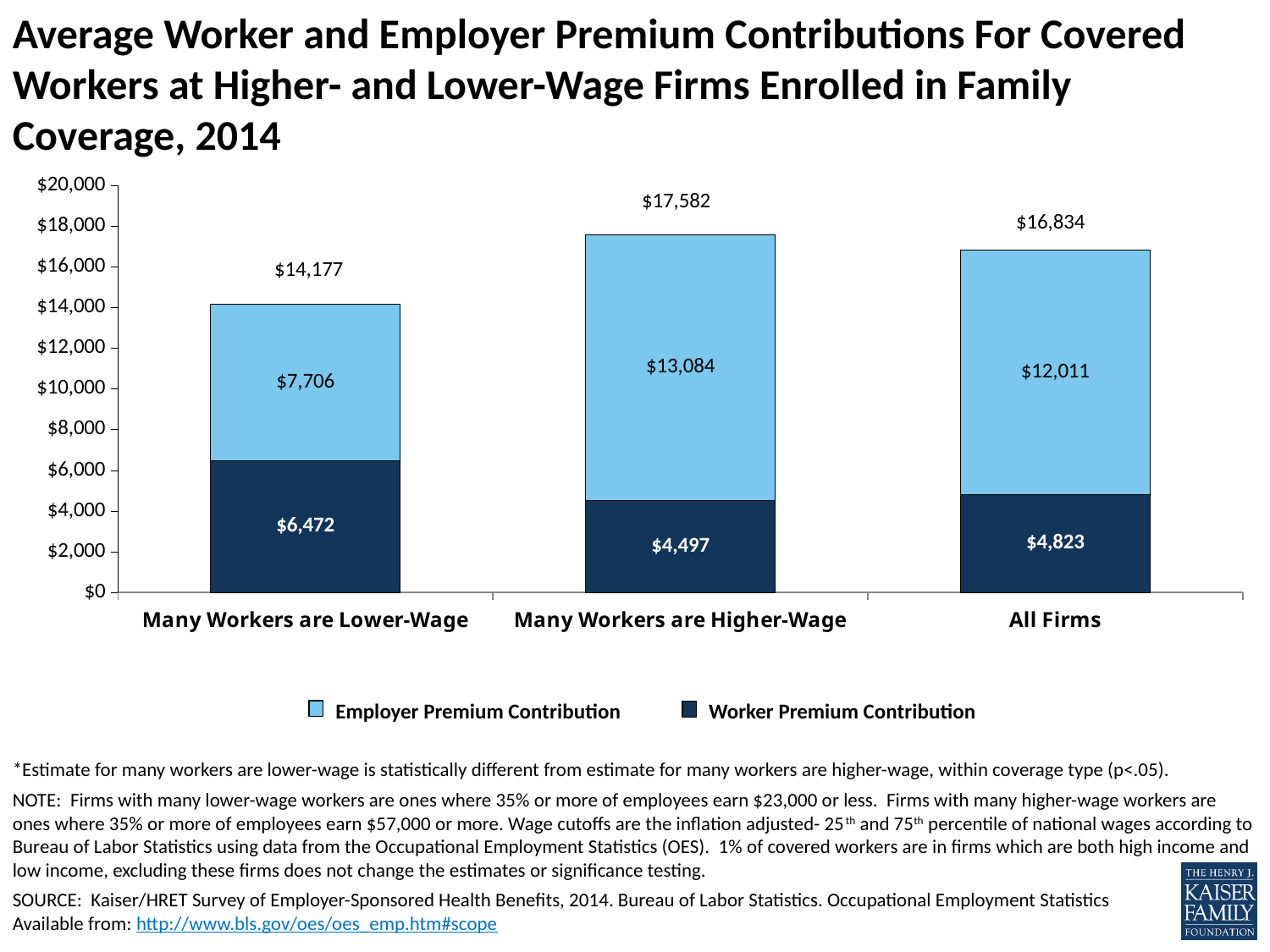
Is the total premium for Many Workers are Lower-Wage greater or less than $16,000? less Which series is shown in dark blue? Worker Premium Contribution What kind of chart is shown on the slide? Stacked bar chart What is the total premium shown above the All Firms bar? $16,834 Which category has the lowest Employer Premium Contribution? Many Workers are Lower-Wage How many series does the legend list? 2 Which is larger, the Worker Premium Contribution for Many Workers are Lower-Wage or for Many Workers are Higher-Wage? Many Workers are Lower-Wage How many categories are shown on the x axis? 3 What is the difference between the Employer Premium Contribution for All Firms and for Many Workers are Lower-Wage? $4,305 Which category has the highest total premium? Many Workers are Higher-Wage What is the Worker Premium Contribution for Many Workers are Lower-Wage? $6,472 What is the Employer Premium Contribution for Many Workers are Higher-Wage? $13,084